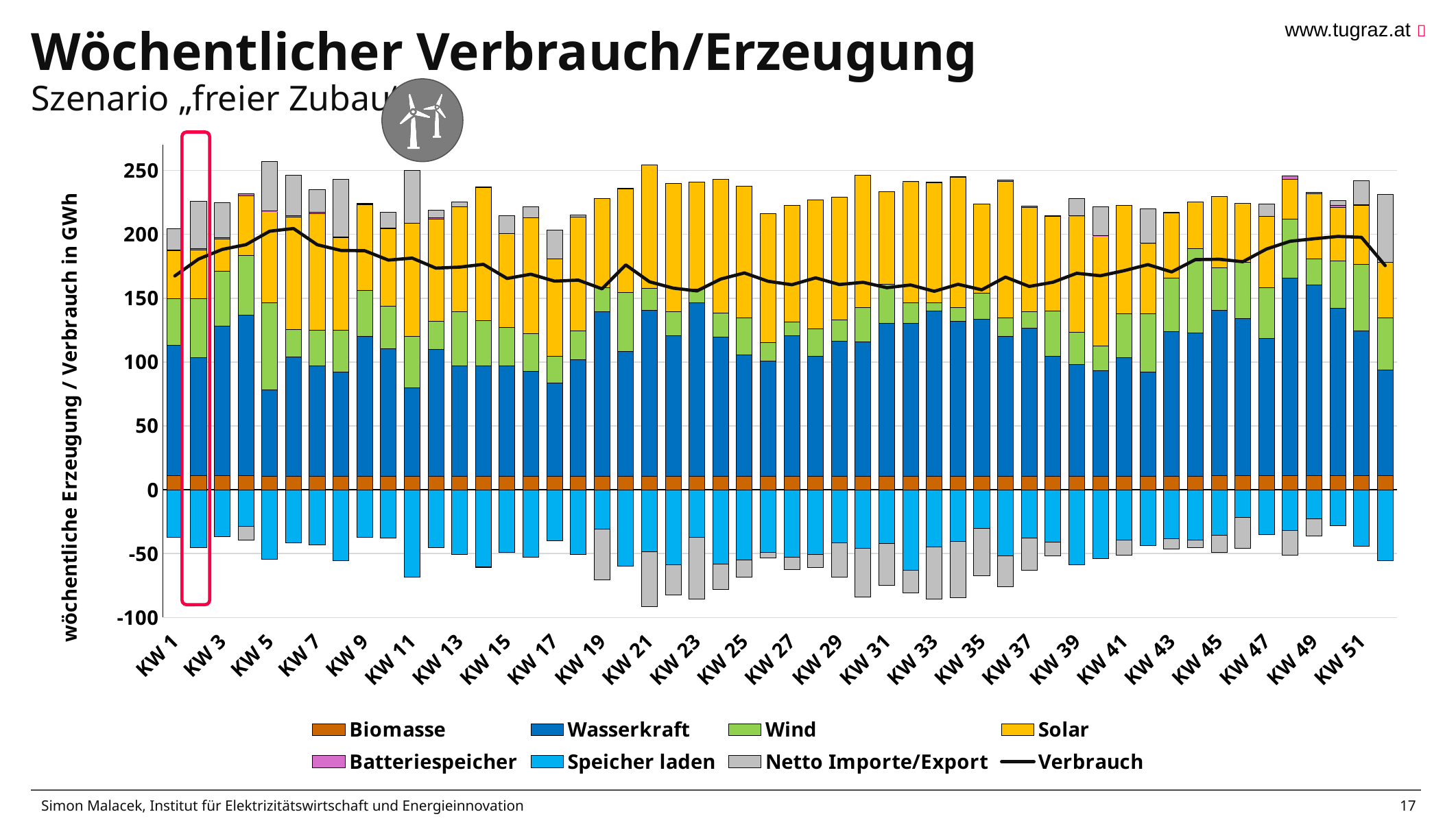
What kind of chart is shown on the slide? Stacked bar chart with a line Is the Verbrauch line at KW 49 greater or less than 150? greater Which week has the larger Wasserkraft segment, KW 1 or KW 49? KW 49 What is the label of the y axis? wöchentliche Erzeugung / Verbrauch in GWh Is the Speicher laden value at KW 11 greater or less than -50? less Does the Verbrauch line rise or fall from KW 1 to KW 5? rise Is the top of the Wasserkraft segment at KW 1 greater or less than 100? greater How many series does the legend list? 8 How many week labels are shown on the x axis? 26 What is the title of the slide's chart? Wöchentlicher Verbrauch/Erzeugung